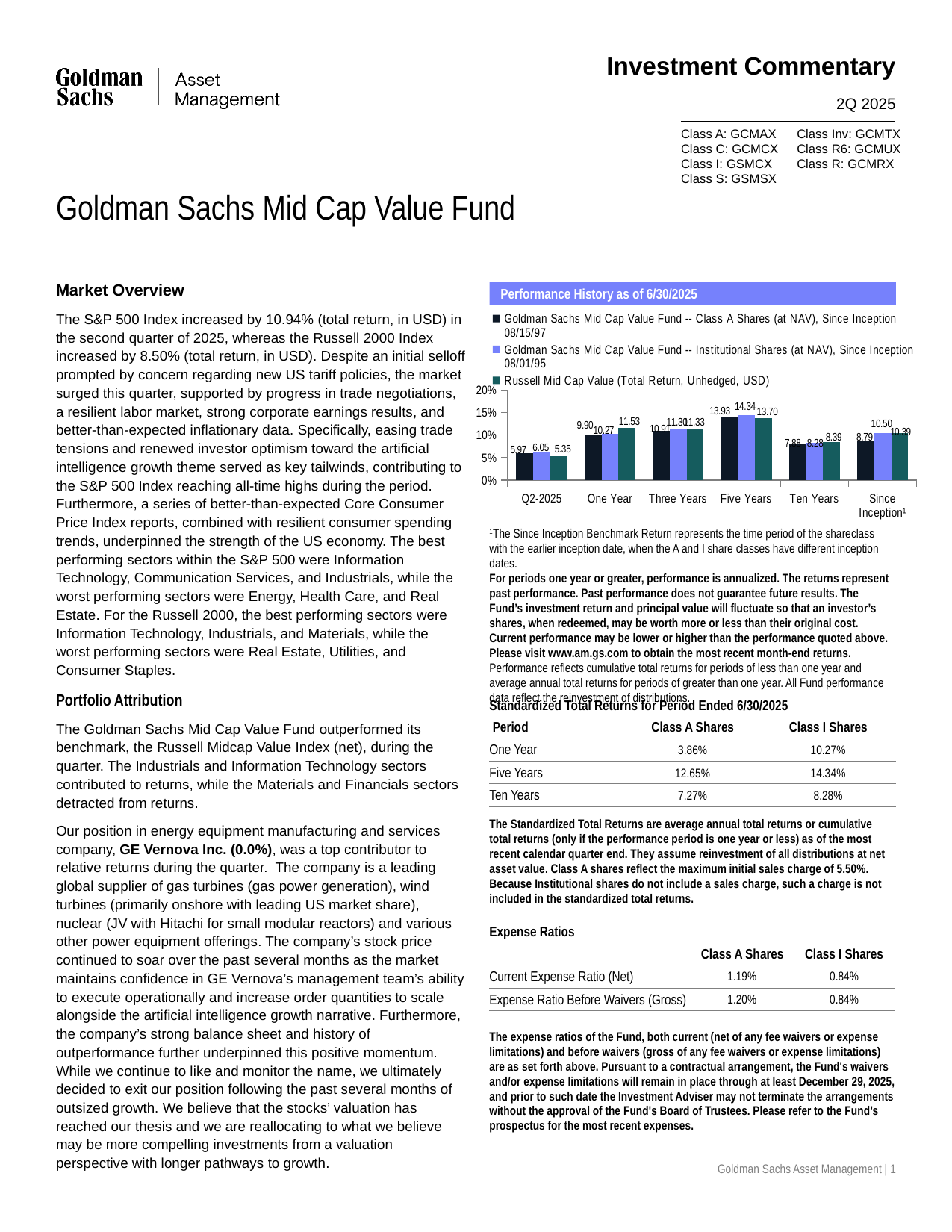
What is the title of the chart on the slide? Performance History as of 6/30/2025 What kind of chart is shown under 'Performance History as of 6/30/2025'? Bar chart In the Performance History chart, what is the value for Institutional Shares for Five Years? 14.34 How many series does the legend of the Performance History chart list? 3 In the Performance History chart, what is the One Year value for Russell Mid Cap Value? 11.53 How many period categories are shown on the x axis of the Performance History chart? 6 In the Performance History chart, what is the difference between the Institutional Shares and Class A Shares values for Five Years? 0.41 In the Performance History chart, which period has the lowest value for Russell Mid Cap Value? Q2-2025 In the Performance History chart, for One Year, which is larger: Class A Shares or Russell Mid Cap Value? Russell Mid Cap Value In the Performance History chart, which period has the highest value for Class A Shares? Five Years In the Performance History chart, is the Five Years value for Class A Shares greater or less than 10%? greater In the Performance History chart, what is the value for Class A Shares for Q2-2025? 5.97